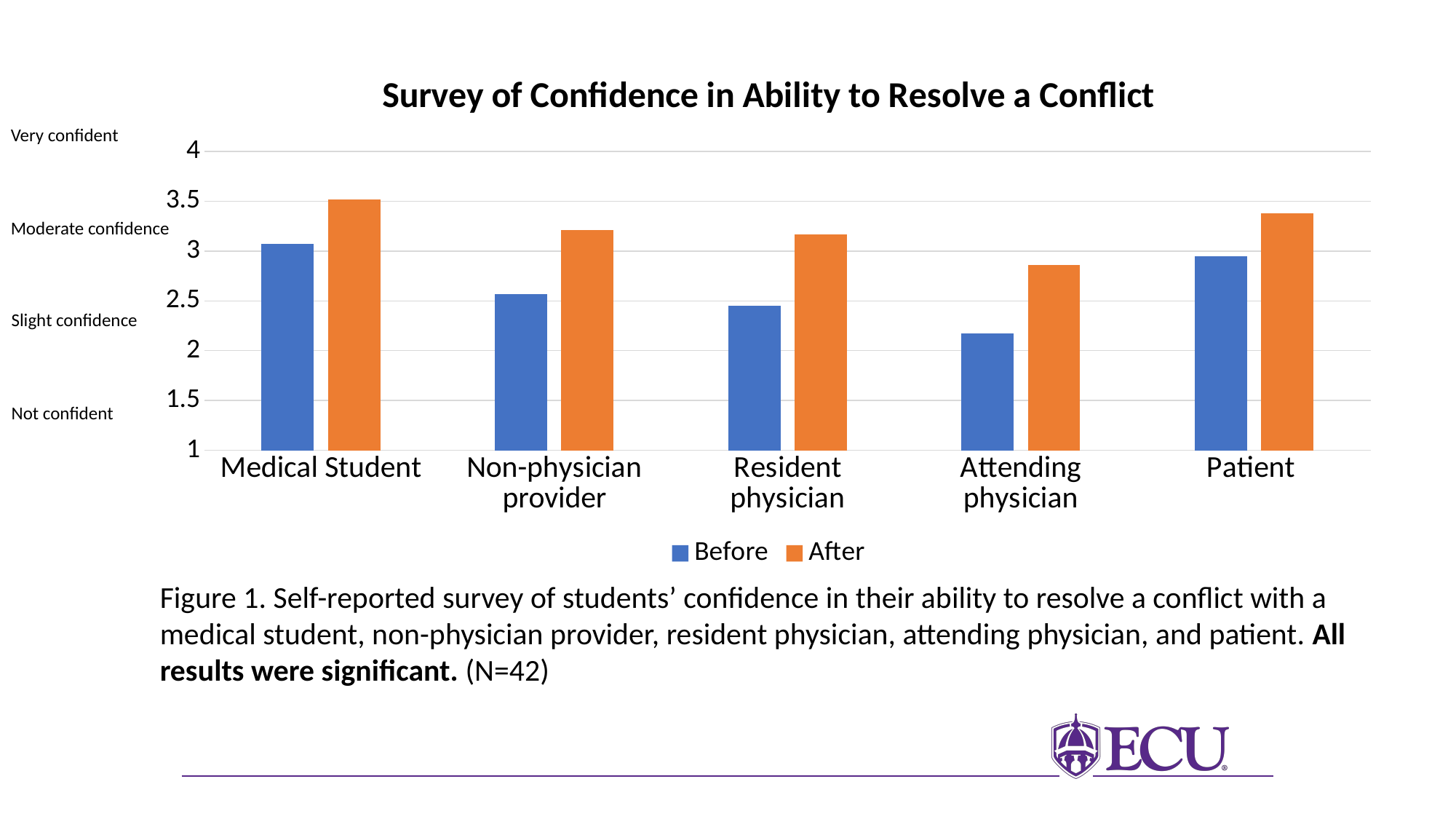
What is the title of the chart? Survey of Confidence in Ability to Resolve a Conflict What kind of chart is shown on the slide? bar chart Which category has the lowest After value? Attending physician How many categories are shown on the x axis? 5 Which category has the lowest Before value? Attending physician Is the Before value for Attending physician greater or less than 2.5? less Is the After value for Non-physician provider greater or less than 3? greater Which category has the highest After value? Medical Student Which is larger: the After value for Patient or the After value for Non-physician provider? Patient For every category, is the After bar higher or lower than the Before bar? higher How many series does the legend list? 2 Is the After value for Attending physician greater or less than 3? less